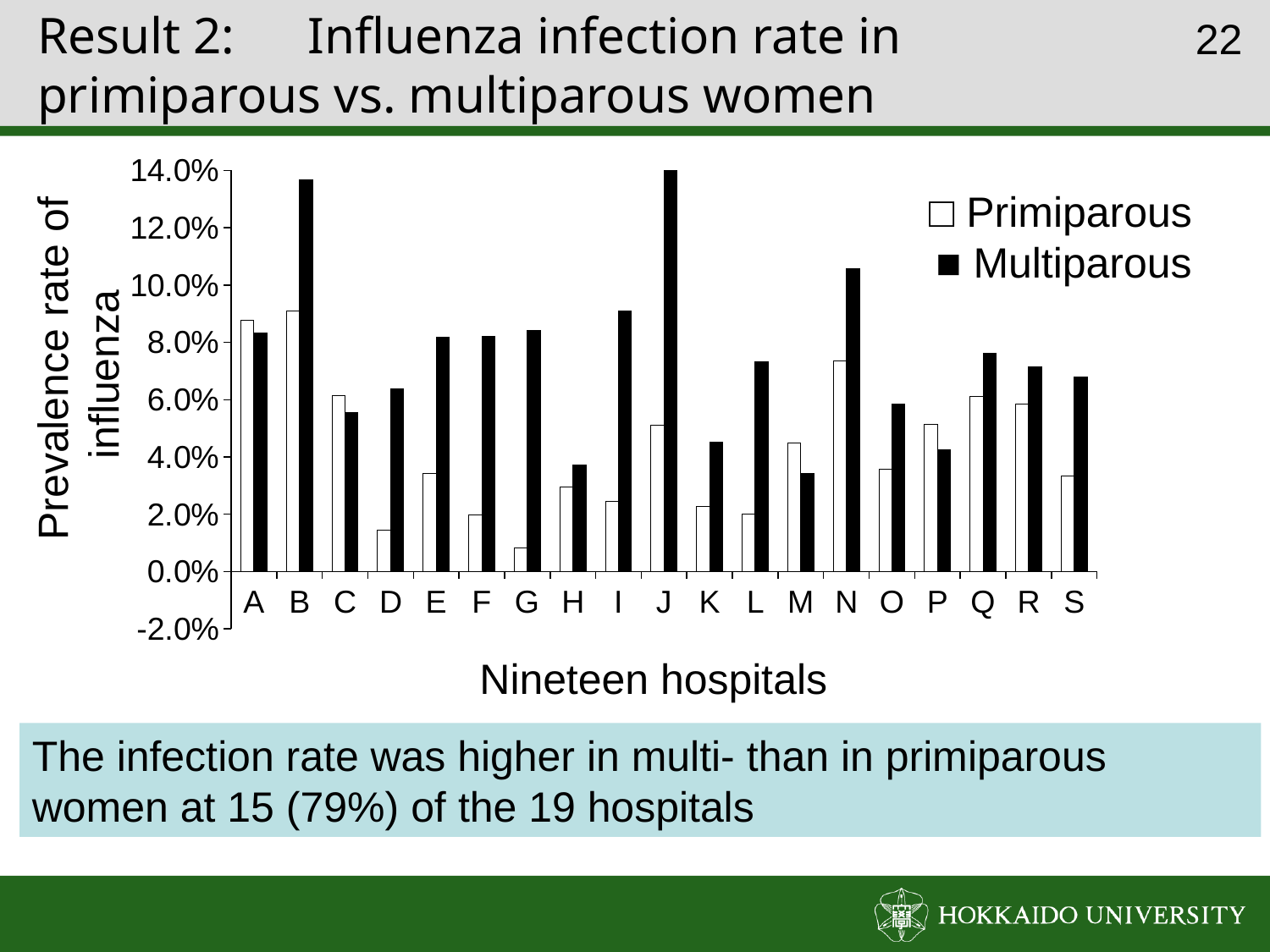
Is the Multiparous value for hospital N greater or less than 10.0%? greater Is the Primiparous value for hospital G greater or less than 2.0%? less Is the Primiparous value for hospital D greater or less than 4.0%? less At hospital M, which is larger: the Primiparous or the Multiparous prevalence rate? Primiparous What is the title of the x axis of the chart? Nineteen hospitals At hospital D, which is larger: the Primiparous or the Multiparous prevalence rate? Multiparous Which hospital has the lowest Primiparous prevalence rate? G What kind of chart is shown on the slide? bar chart How many series does the chart's legend list? 2 What are the two series named in the chart's legend? Primiparous and Multiparous How many hospitals (categories) are shown on the x axis of the chart? 19